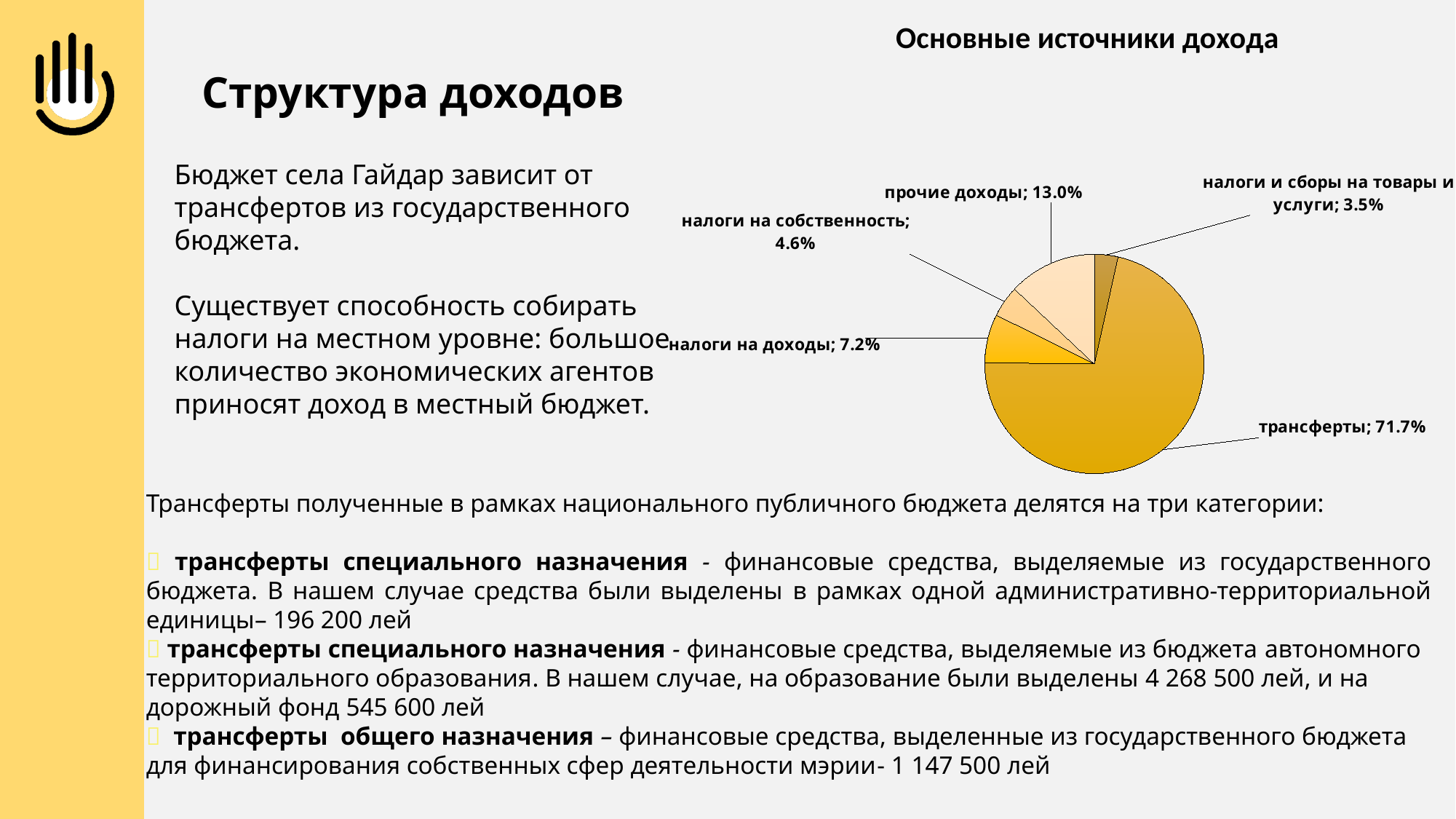
Which category has the largest share of the pie? трансферты What is the value shown for налоги на доходы? 7.2% Which category has the smallest share of the pie? налоги и сборы на товары и услуги What is the difference between the shares of прочие доходы and налоги на доходы? 5.8% Which is larger, налоги на собственность or налоги на доходы? налоги на доходы What is the value shown for налоги на собственность? 4.6% What is the title of the chart? Основные источники дохода How many slices does the pie chart have? 5 What type of chart is shown on the slide? pie chart What is the value shown for налоги и сборы на товары и услуги? 3.5% What is the value shown for прочие доходы? 13.0% What share of the pie does трансферты take? 71.7%